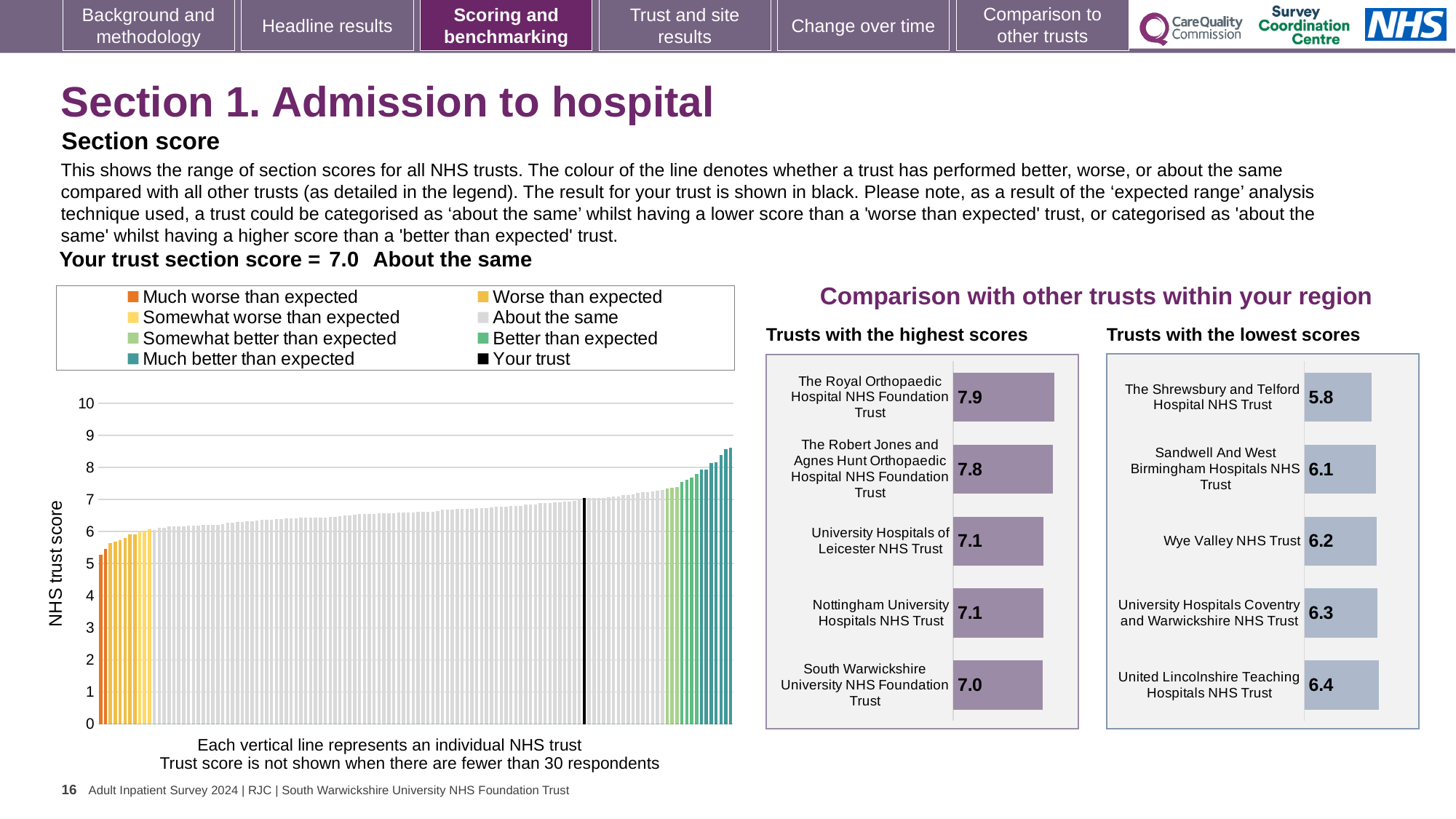
In the 'Trusts with the lowest scores' chart, what is the difference between the scores of United Lincolnshire Teaching Hospitals NHS Trust and The Shrewsbury and Telford Hospital NHS Trust? 0.6 In the 'Trusts with the highest scores' chart, how many trusts are listed? 5 In the large chart on the left showing all NHS trust scores, how many entries does the legend list? 8 In the 'Trusts with the lowest scores' chart, what is the score for Wye Valley NHS Trust? 6.2 In the 'Trusts with the highest scores' chart, which trust has the highest score? The Royal Orthopaedic Hospital NHS Foundation Trust In the 'Trusts with the lowest scores' chart, which trust has the lowest score? The Shrewsbury and Telford Hospital NHS Trust In the 'Trusts with the highest scores' chart, what is the difference between the scores of The Royal Orthopaedic Hospital NHS Foundation Trust and South Warwickshire University NHS Foundation Trust? 0.9 In the large chart on the left, is the value of the leftmost (lowest) bar greater or less than 6? less In the 'Trusts with the lowest scores' chart, which has the larger score: Sandwell And West Birmingham Hospitals NHS Trust or United Lincolnshire Teaching Hospitals NHS Trust? United Lincolnshire Teaching Hospitals NHS Trust In the 'Trusts with the highest scores' chart, what is the score for The Royal Orthopaedic Hospital NHS Foundation Trust? 7.9 What kind of chart is the large chart on the left showing NHS trust scores? Bar chart In the large chart on the left, do the NHS trust scores rise or fall from left to right? Rise